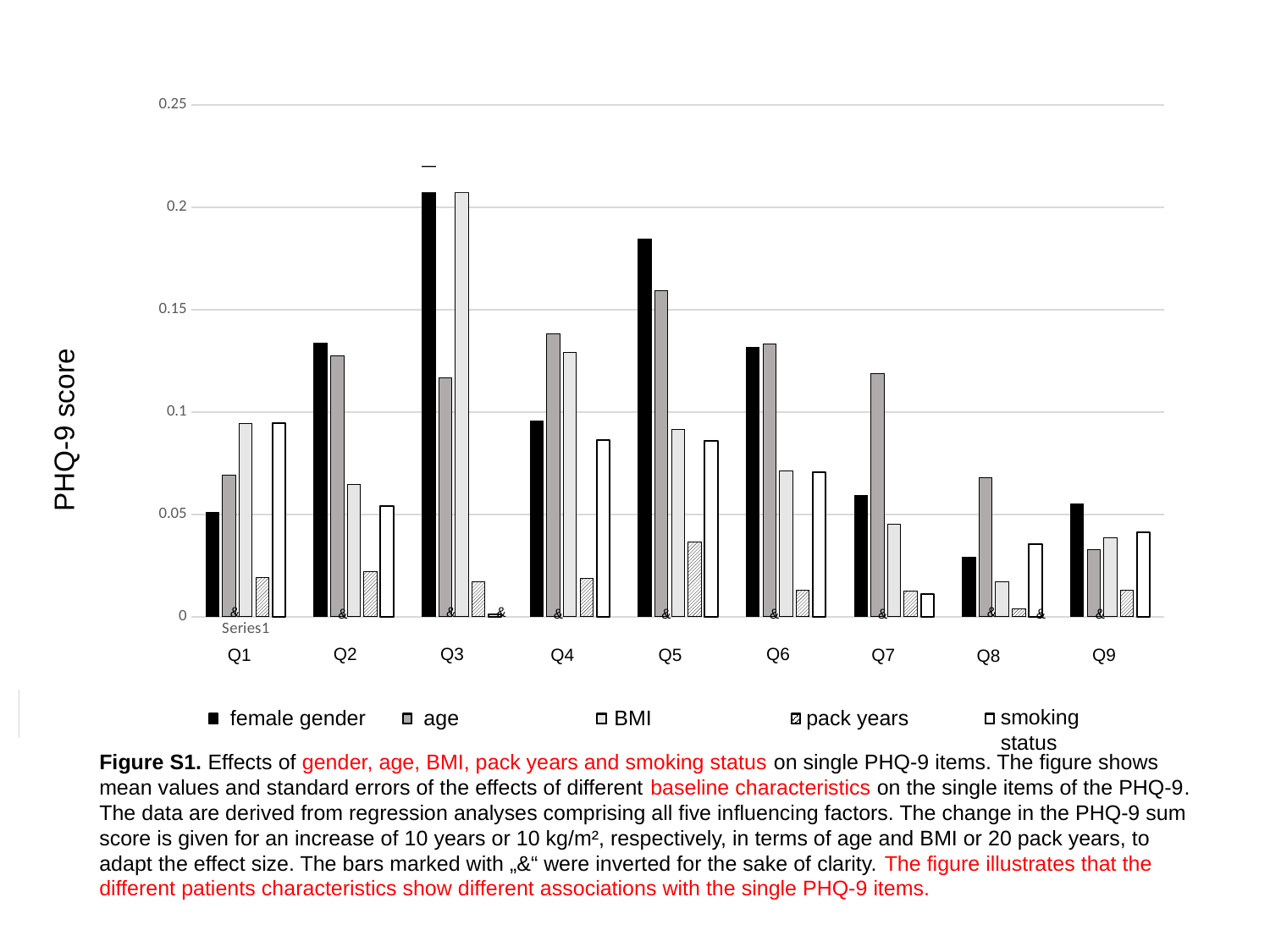
How many series does the legend list? 5 Is the age value for Q9 greater or less than 0.05? less Is the BMI value for Q4 greater or less than 0.1? greater For which PHQ-9 item is the age bar highest? Q5 How many PHQ-9 items (categories) are shown on the x axis? 9 What is the label of the y axis? PHQ-9 score For which PHQ-9 item is the female gender bar highest? Q3 For which PHQ-9 item is the pack years bar highest? Q5 For Q7, which is larger: the age bar or the female gender bar? age For which PHQ-9 item is the smoking status bar lowest? Q3 Is the female gender value for Q3 greater or less than 0.2? greater What kind of chart is shown on the slide? bar chart